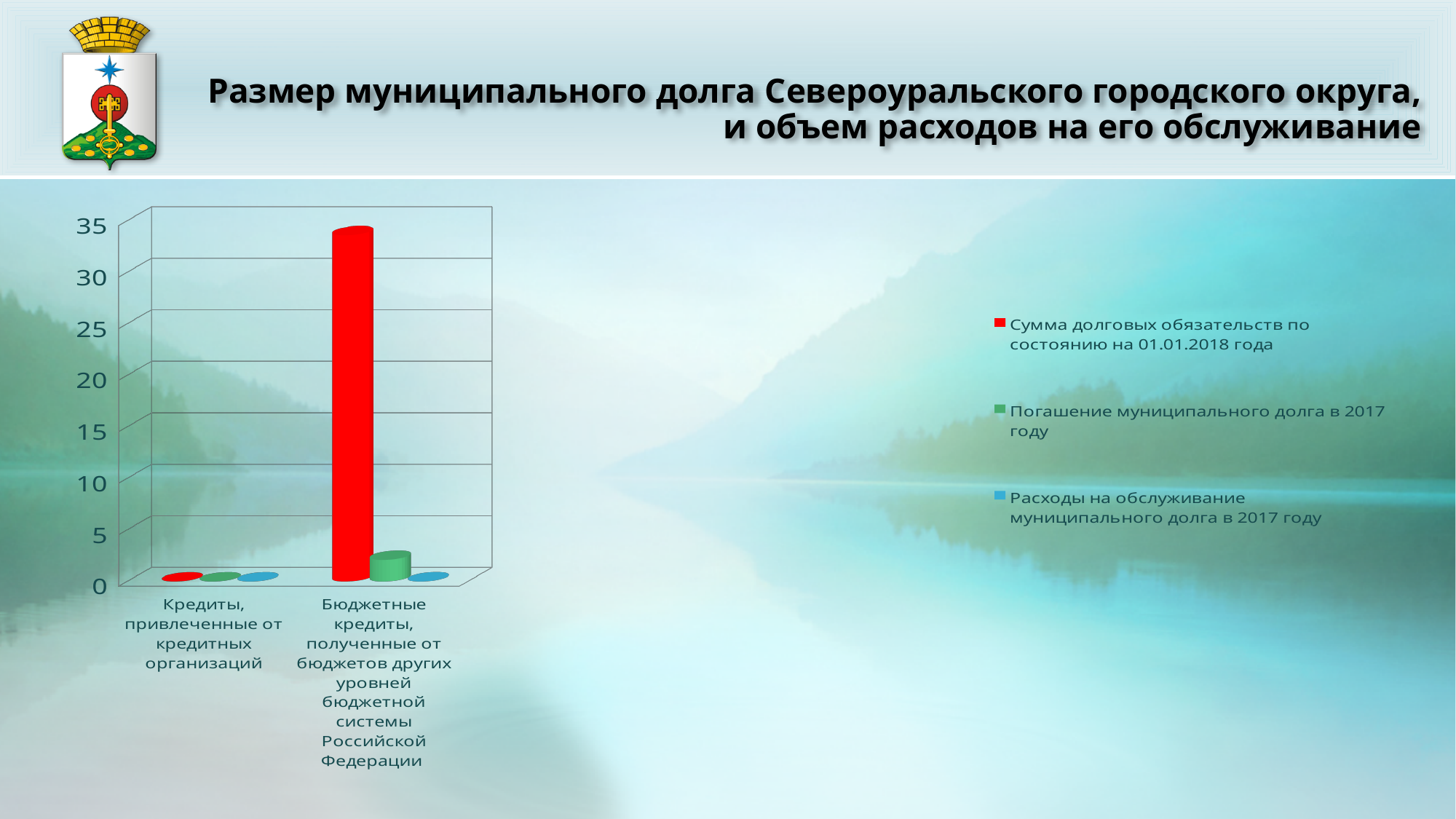
Is the value of 'Сумма долговых обязательств по состоянию на 01.01.2018 года' for 'Кредиты, привлеченные от кредитных организаций' greater or less than 5? less How many categories are shown on the x axis of the chart? 2 Which series has the highest value for 'Бюджетные кредиты, полученные от бюджетов других уровней бюджетной системы Российской Федерации'? Сумма долговых обязательств по состоянию на 01.01.2018 года What is the highest value shown on the vertical axis of the chart? 35 Does the value of 'Сумма долговых обязательств по состоянию на 01.01.2018 года' rise or fall from the first category to the second category? rise How many series does the chart legend list? 3 What colour represents 'Погашение муниципального долга в 2017 году' in the chart? Green Is the value of 'Сумма долговых обязательств по состоянию на 01.01.2018 года' for 'Бюджетные кредиты, полученные от бюджетов других уровней бюджетной системы Российской Федерации' greater or less than 30? greater For 'Бюджетные кредиты, полученные от бюджетов других уровней бюджетной системы Российской Федерации', which is larger: 'Сумма долговых обязательств по состоянию на 01.01.2018 года' or 'Погашение муниципального долга в 2017 году'? Сумма долговых обязательств по состоянию на 01.01.2018 года Which category has the higher value for 'Сумма долговых обязательств по состоянию на 01.01.2018 года'? Бюджетные кредиты, полученные от бюджетов других уровней бюджетной системы Российской Федерации Is the value of 'Погашение муниципального долга в 2017 году' for 'Бюджетные кредиты, полученные от бюджетов других уровней бюджетной системы Российской Федерации' greater or less than 5? less What kind of chart is shown on the slide? Bar chart